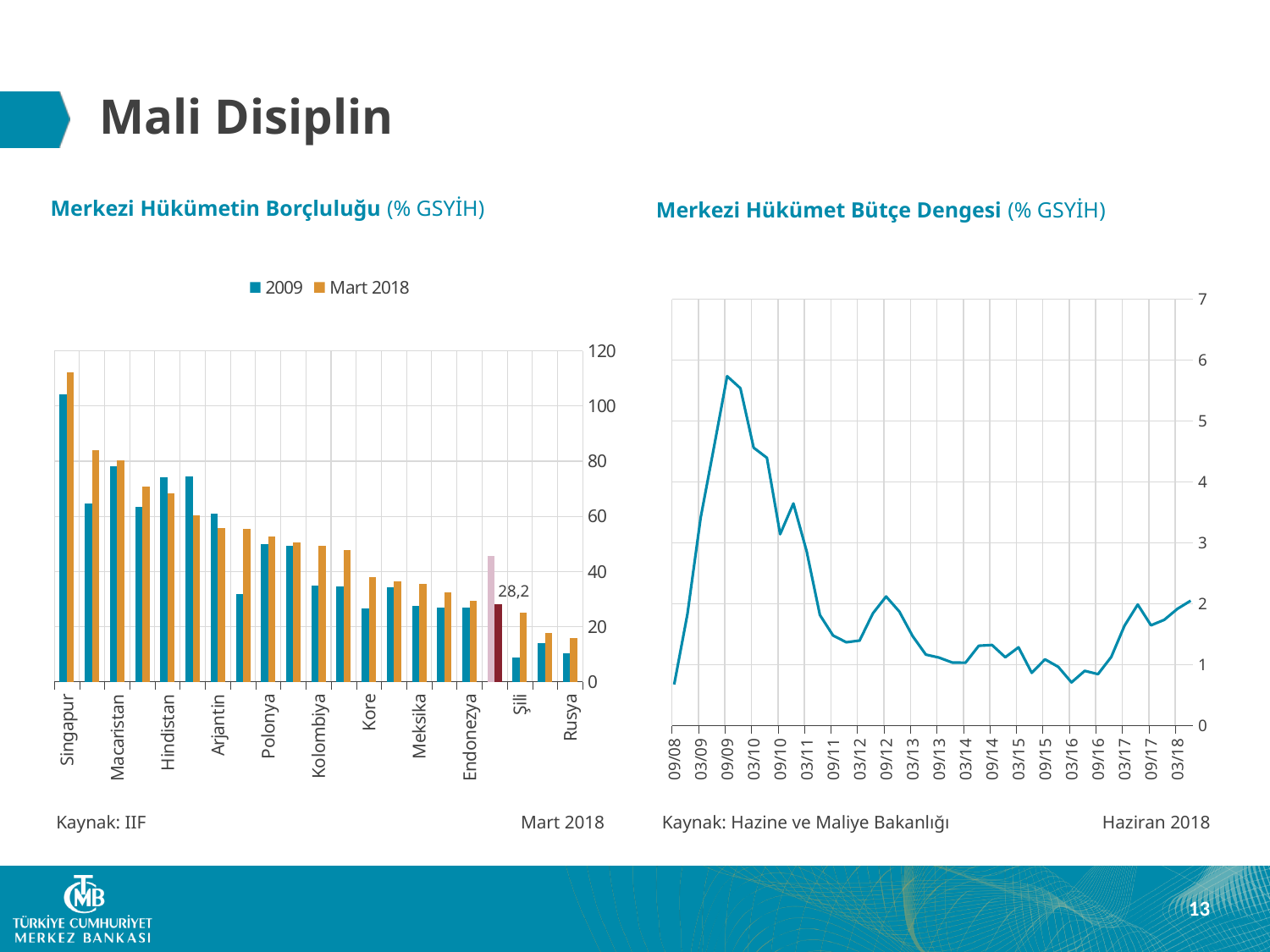
In the right chart, is the peak value around 09/09 greater or less than 5? greater In the left chart, is the Mart 2018 value for Macaristan greater or less than 60? greater What kind of chart is the 'Merkezi Hükümet Bütçe Dengesi' chart on the right? line chart In the left chart, is the 2009 value for Rusya greater or less than 20? less In the left chart, which country has the highest Mart 2018 value? Singapur How many series does the legend of the left chart list? 2 What value is printed as a data label on the left chart? 28,2 In the left chart, which is larger for Kore: the 2009 value or the Mart 2018 value? Mart 2018 What kind of chart is the 'Merkezi Hükümetin Borçluluğu' chart on the left? bar chart What are the two legend entries of the left chart? 2009 and Mart 2018 In the right chart, does the line rise or fall between 09/09 and 03/16? fall